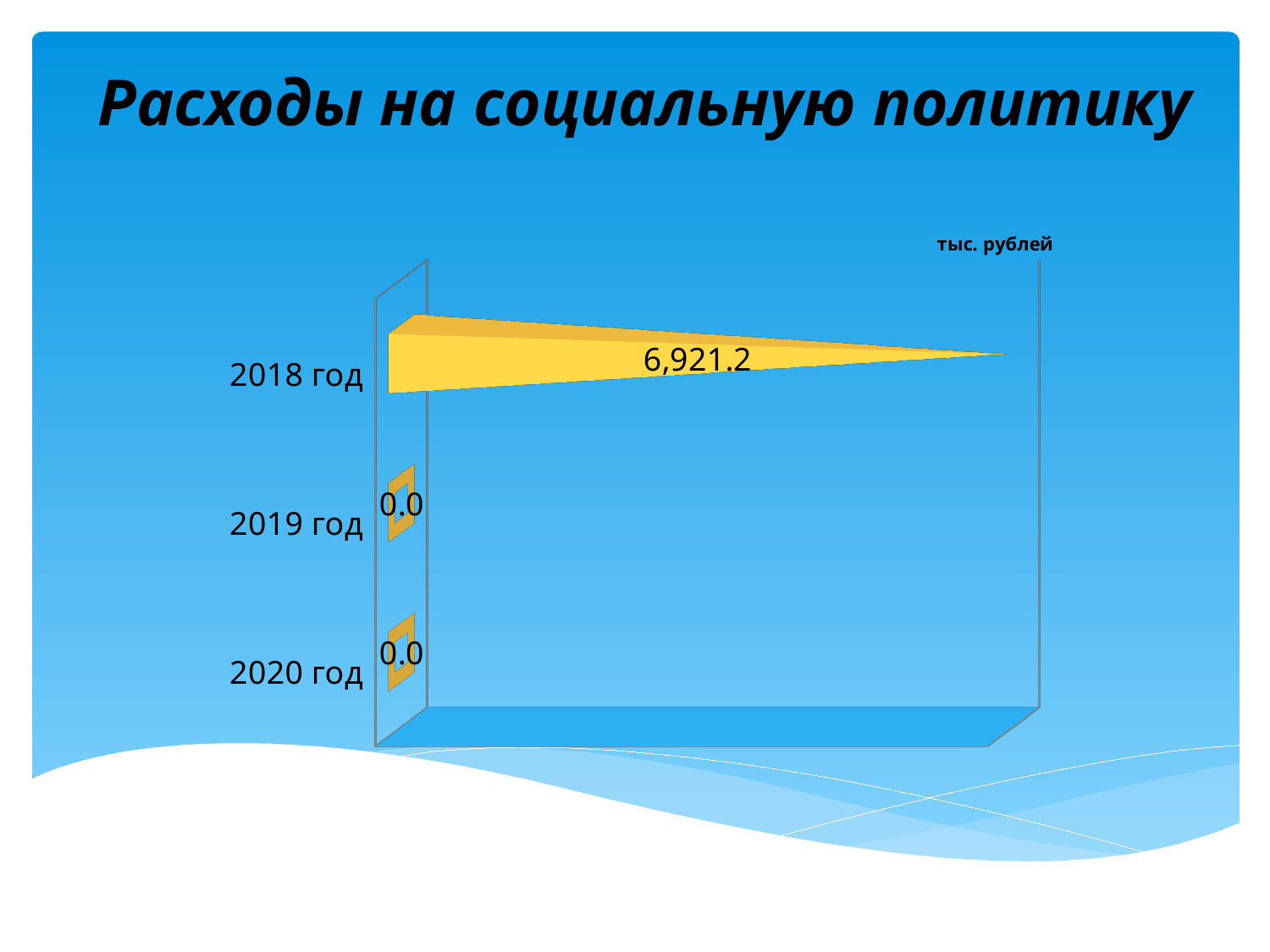
How many categories are shown in the chart? 3 What is the value for 2020 год? 0.0 Do the values rise or fall from 2018 год to 2020 год? fall What is the value for 2018 год? 6,921.2 What is the value for 2019 год? 0.0 Which year has the highest value? 2018 год What is the title of the slide? Расходы на социальную политику What is the difference between the values for 2018 год and 2019 год? 6,921.2 What unit is indicated for the chart values? тыс. рублей What kind of chart is shown on the slide? bar chart Which is larger, the value for 2018 год or the value for 2020 год? 2018 год